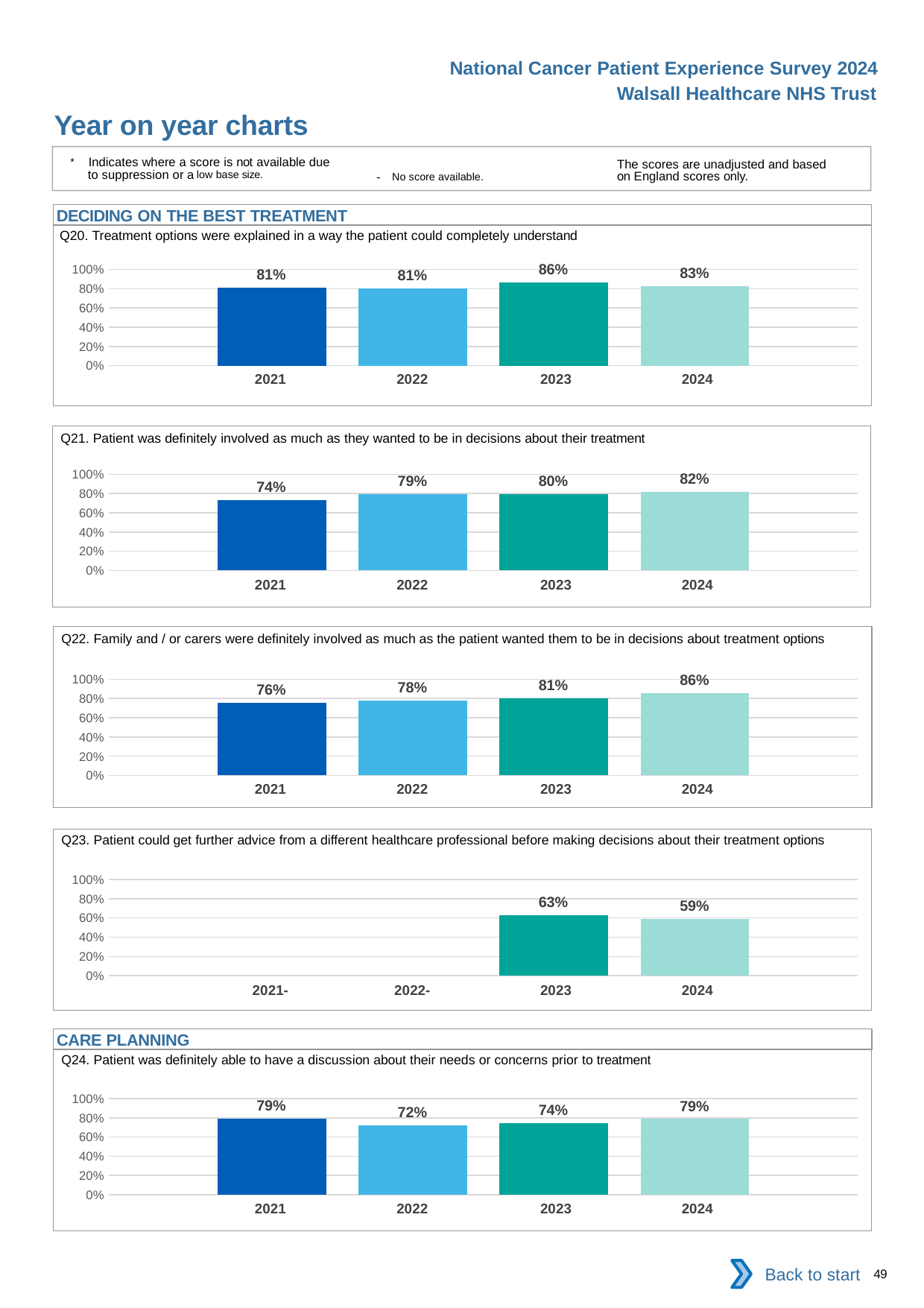
In the Q20 chart, which year has the highest value? 2023 What kind of chart is the Q24 chart? bar chart In the Q24 chart, what is the difference between the 2021 and 2022 values? 7% In the Q22 chart, what is the value for 2024? 86% In the Q21 chart, what is the value for 2021? 74% In the Q20 chart, what is the value for 2023? 86% In the Q23 chart, how many years have a bar plotted? 2 In the Q21 chart, what is the difference between the 2024 and 2021 values? 8% In the Q24 chart, what is the value for 2022? 72% In the Q23 chart, which is larger, the value for 2023 or 2024? 2023 In the Q22 chart, which year has the lowest value? 2021 In the Q21 chart, do the values rise or fall from 2021 to 2024? rise